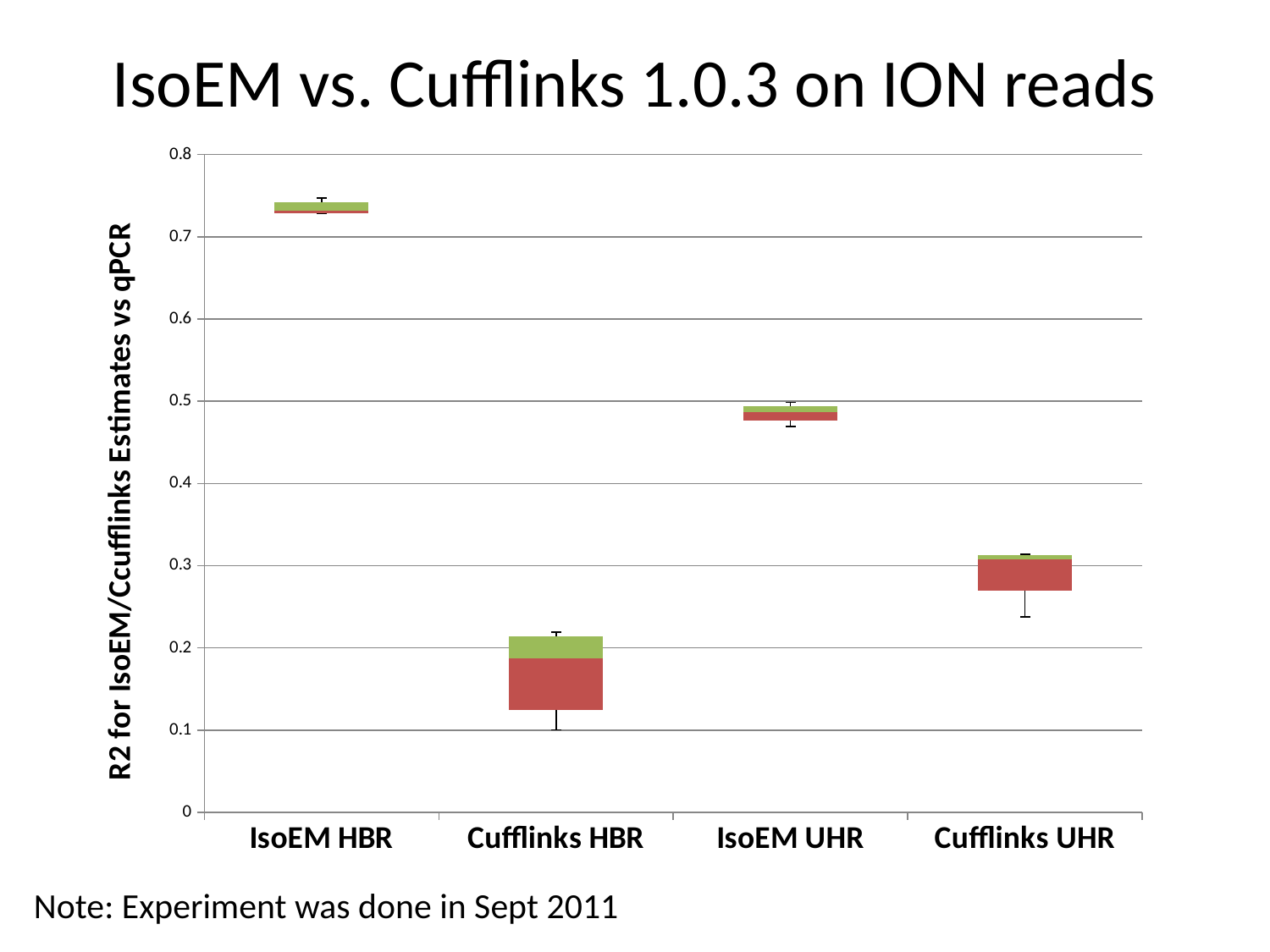
How many categories are shown along the x axis of the chart? 4 Which has the higher R2 value, IsoEM UHR or Cufflinks UHR? IsoEM UHR What is the label on the vertical axis of the chart? R2 for IsoEM/Ccufflinks Estimates vs qPCR Is the value for Cufflinks HBR greater or less than 0.3? less Is the value for Cufflinks UHR greater or less than 0.2? greater Which category has the highest R2 value in the chart? IsoEM HBR Is the value for IsoEM HBR greater or less than 0.7? greater What is the title of the chart? IsoEM vs. Cufflinks 1.0.3 on ION reads What is the highest value shown on the vertical axis of the chart? 0.8 Which has the higher R2 value, IsoEM HBR or Cufflinks HBR? IsoEM HBR Which category has the lowest R2 value in the chart? Cufflinks HBR